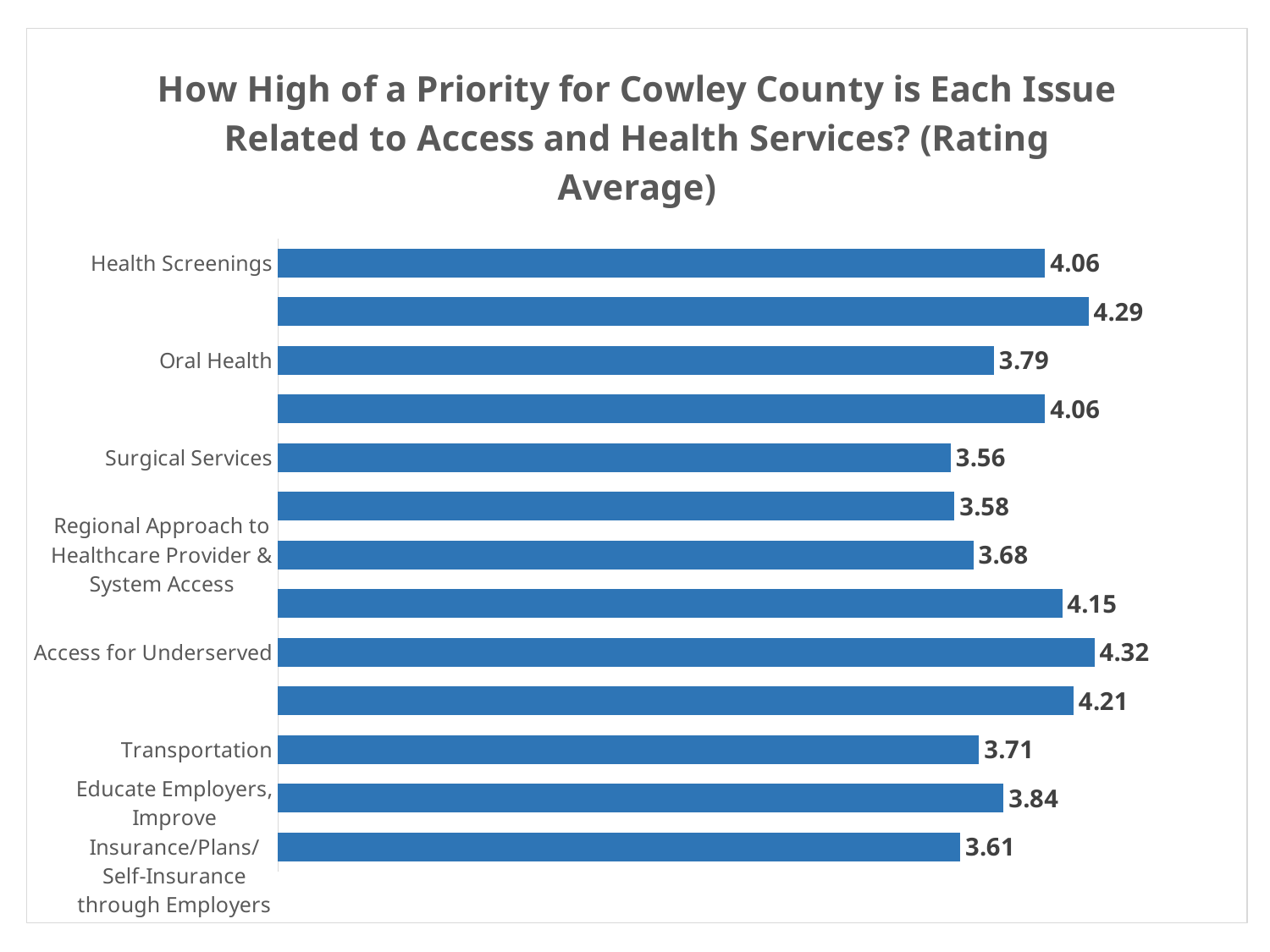
What is the rating average for Access for Underserved? 4.32 What is the rating average for Oral Health? 3.79 What is the rating average for Regional Approach to Healthcare Provider & System Access? 3.68 Which issue has the highest rating average? Access for Underserved How many bars are plotted in the chart? 13 What kind of chart is shown on the slide? Bar chart What is the rating average for Health Screenings? 4.06 What is the difference between the rating averages for Health Screenings and Oral Health? 0.27 What is the rating average for Transportation? 3.71 Which has a higher rating average, Transportation or Oral Health? Oral Health What is the rating average for Surgical Services? 3.56 Which issue has the lowest rating average? Surgical Services